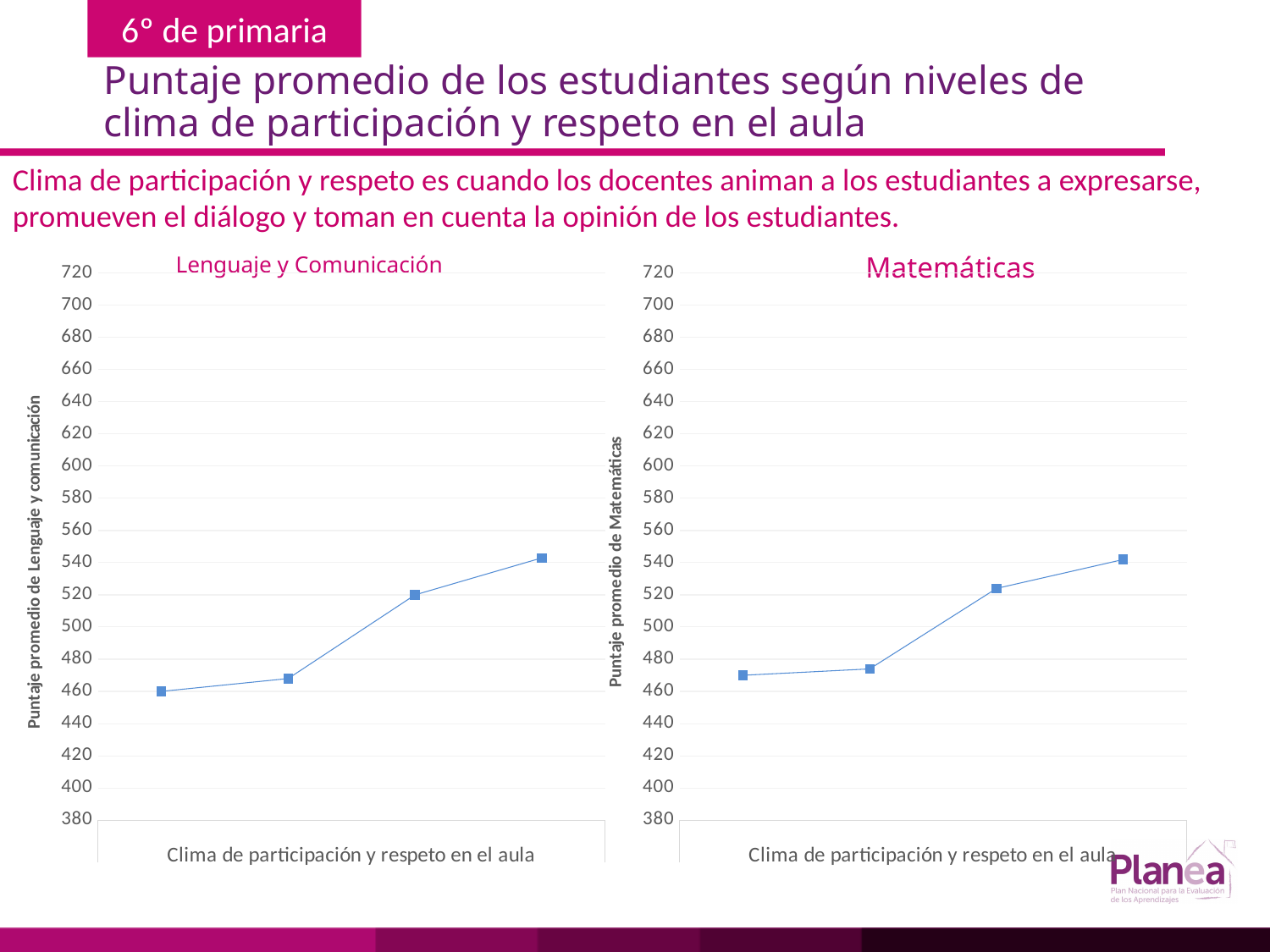
What kind of chart is the Matemáticas chart? line chart On the Lenguaje y Comunicación chart, is the value of the last (rightmost) point greater or less than 520? greater On the Lenguaje y Comunicación chart, is the value of the first (leftmost) point greater or less than 480? less What is the title of the chart on the right side of the slide? Matemáticas What is the x-axis title of the Lenguaje y Comunicación chart? Clima de participación y respeto en el aula On the Matemáticas chart, do the values rise or fall from left to right along the x axis? rise What kind of chart is the Lenguaje y Comunicación chart? line chart On the Lenguaje y Comunicación chart, do the values rise or fall from left to right along the x axis? rise How many data points are plotted on the Matemáticas chart? 4 On the Matemáticas chart, is the value of the first (leftmost) point greater or less than 500? less How many data points are plotted on the Lenguaje y Comunicación chart? 4